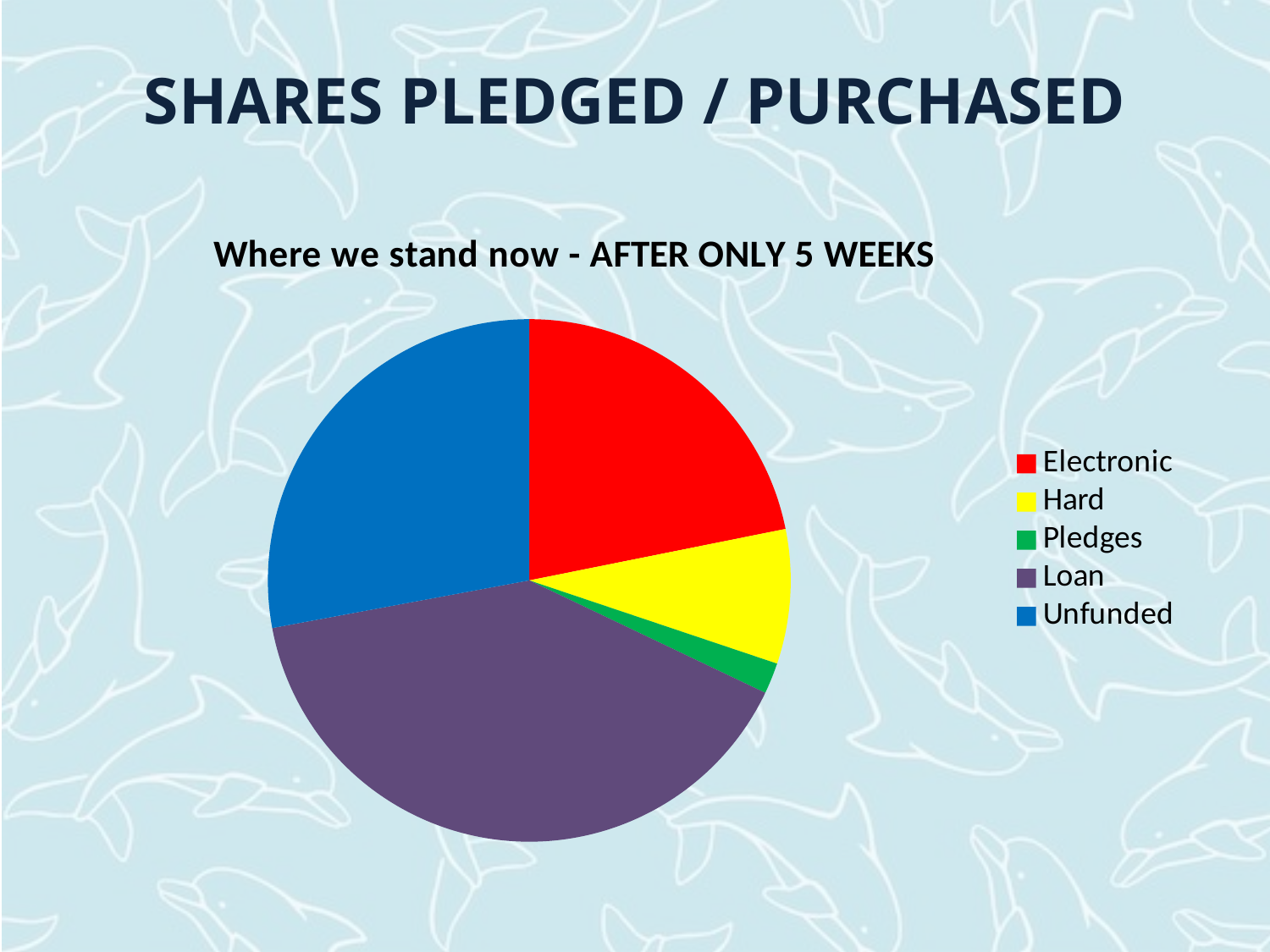
What is the title of the pie chart? Where we stand now - AFTER ONLY 5 WEEKS What colour represents the Loan category in the pie chart? Purple Which slice is larger, Electronic or Hard? Electronic Which slice is larger, Hard or Pledges? Hard How many entries does the legend of the pie chart list? 5 Which category has the largest slice of the pie chart? Loan What kind of chart is shown on the slide? Pie chart Which category has the smallest slice of the pie chart? Pledges Which slice is larger, Loan or Electronic? Loan How many slices does the pie chart have? 5